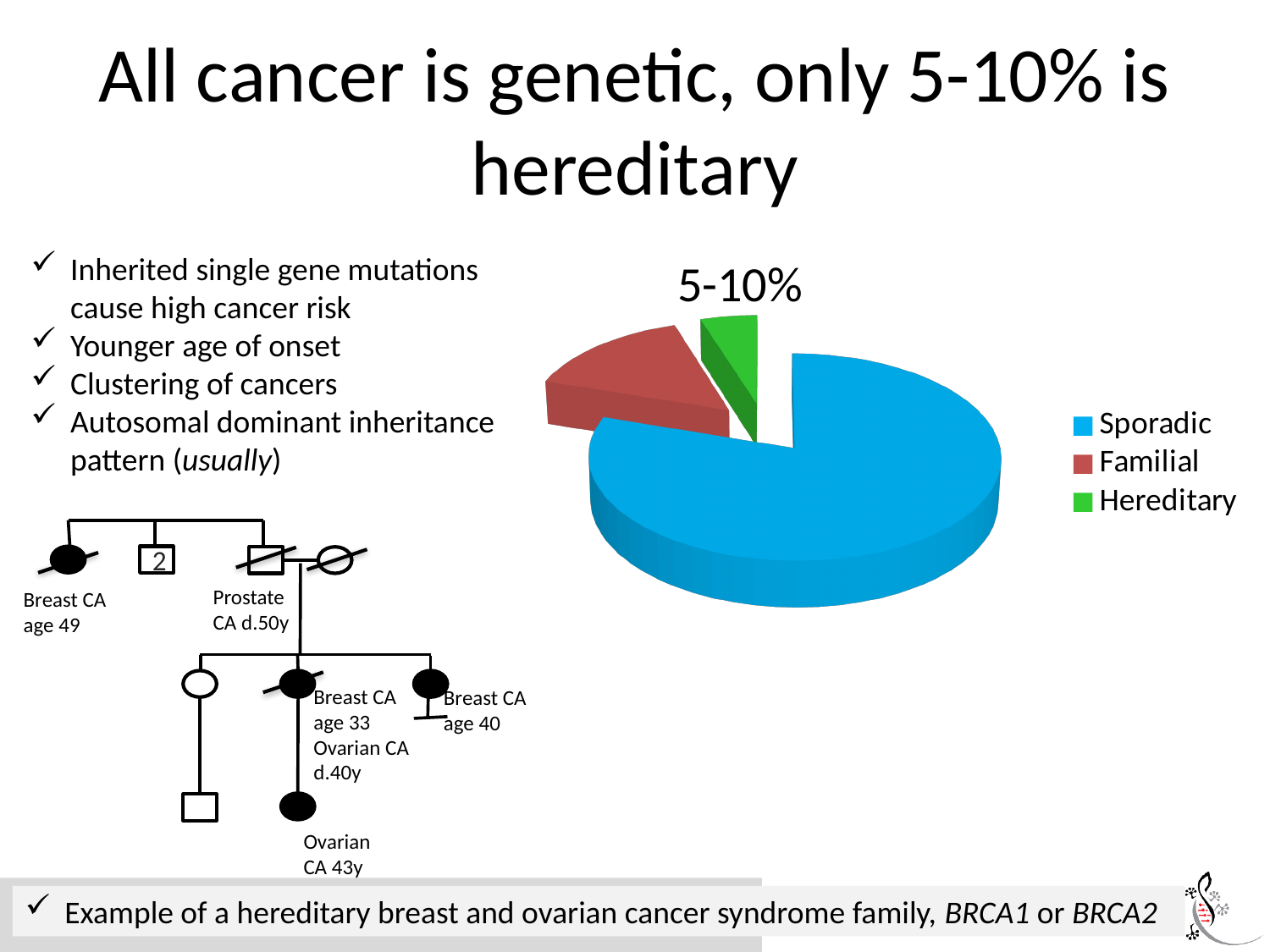
How many entries does the pie chart's legend list? 3 Which category has the largest slice in the pie chart? Sporadic In the pie chart, which slice is larger, Familial or Hereditary? Familial How many slices does the pie chart have? 3 What kind of chart is shown on the right side of the slide? pie chart Which category has the smallest slice in the pie chart? Hereditary In the pie chart, which slice is smaller, Sporadic or Hereditary? Hereditary What percentage label is printed above the pie chart next to the Hereditary slice? 5-10% What colour is the Sporadic slice in the pie chart? blue In the pie chart, which slice is larger, Sporadic or Familial? Sporadic